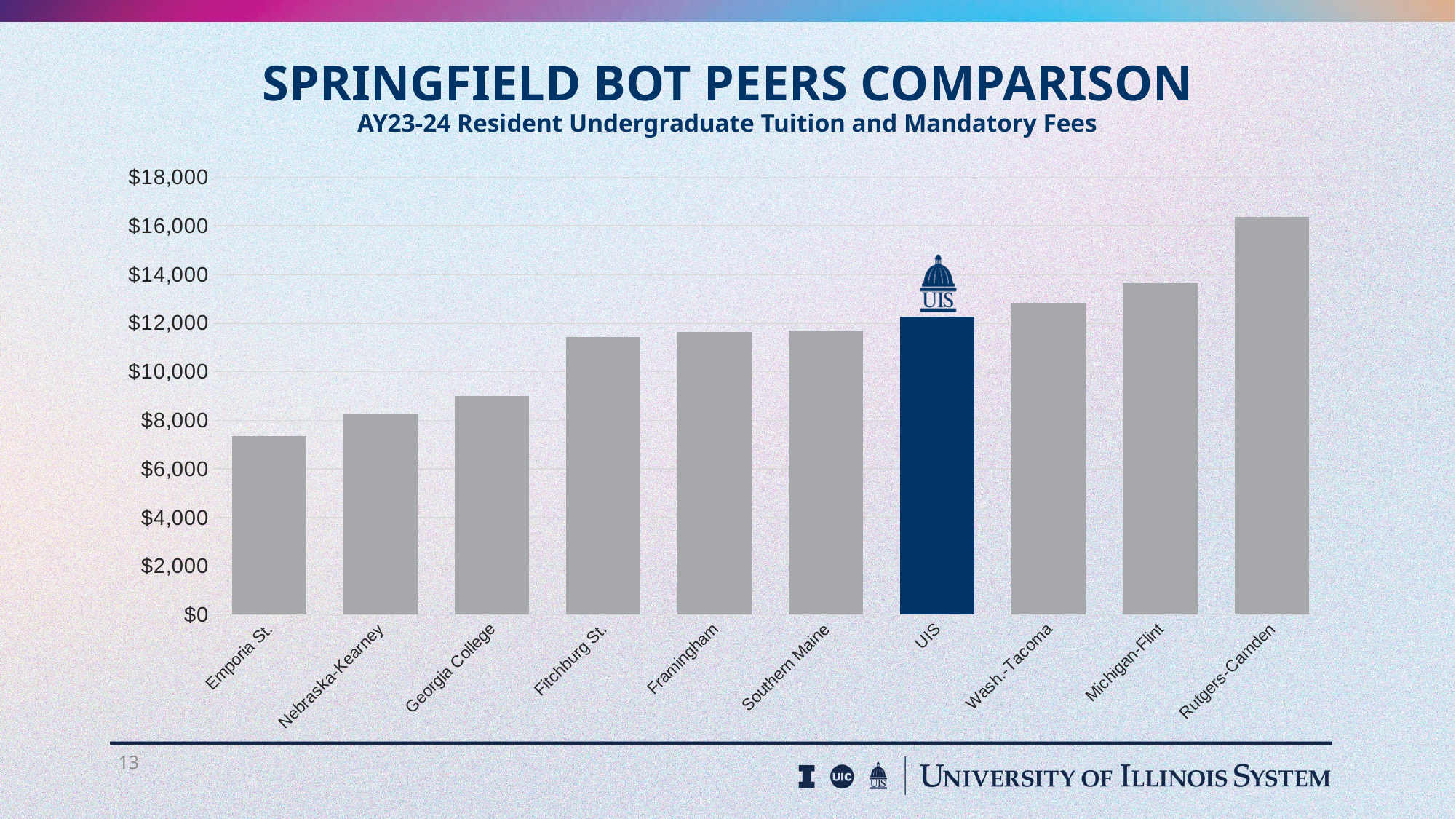
Do the values rise or fall moving from left to right along the x axis? Rise Is the value for Fitchburg St. greater or less than $10,000? greater What kind of chart is shown on the slide? Bar chart How many institutions are shown on the chart? 10 Which institution's bar is shown in dark blue rather than grey? UIS Is the value for Emporia St. greater or less than $8,000? less Is the value for Rutgers-Camden greater or less than $16,000? greater Which is larger, the value for Michigan-Flint or the value for Wash.-Tacoma? Michigan-Flint Which institution has the highest resident undergraduate tuition and mandatory fees? Rutgers-Camden Which institution has the lowest resident undergraduate tuition and mandatory fees? Emporia St.